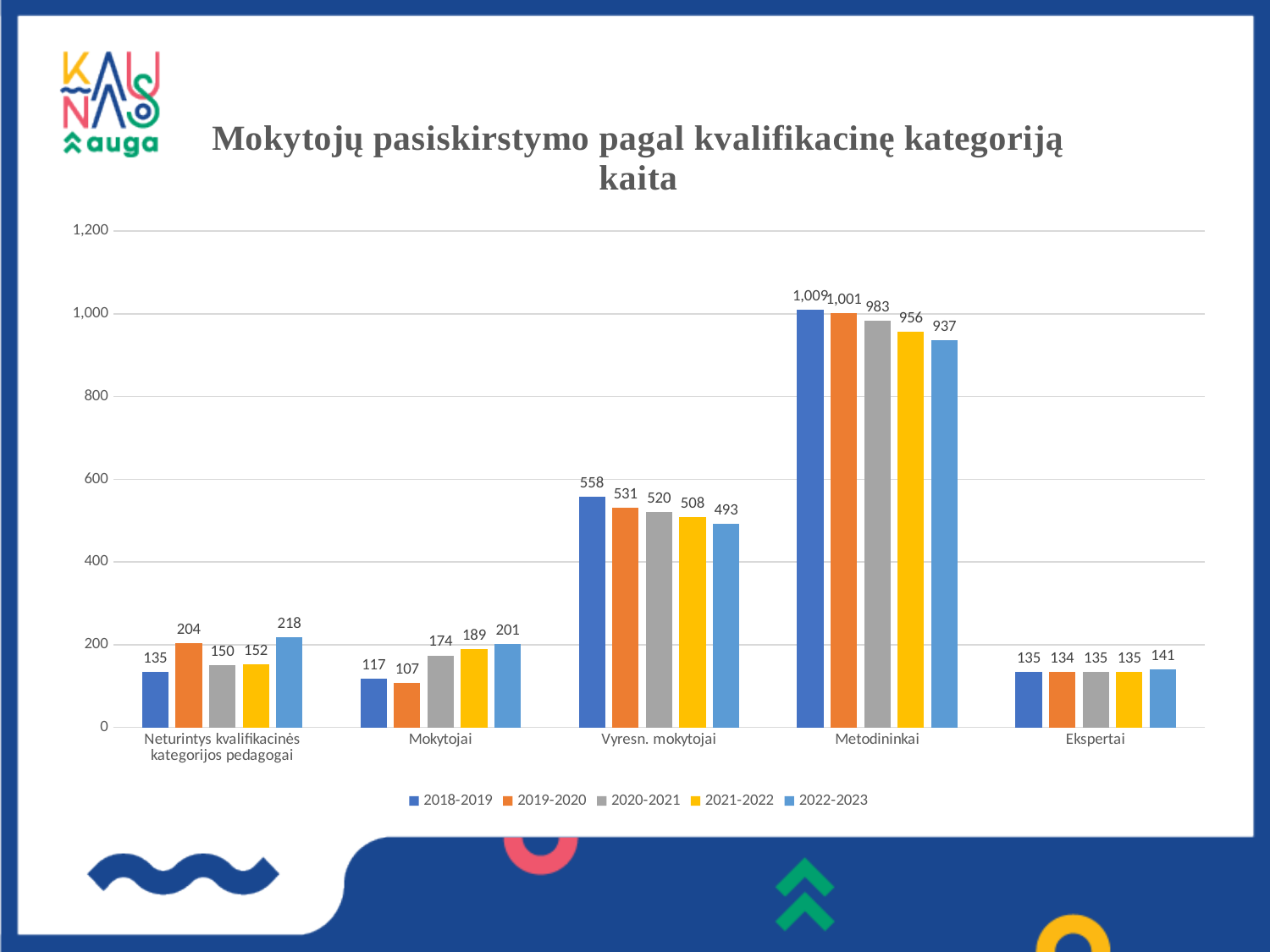
What is the value for Metodininkai in 2022-2023? 937 Which is larger for Neturintys kvalifikacinės kategorijos pedagogai: the 2019-2020 value or the 2022-2023 value? 2022-2023 What is the title of the chart? Mokytojų pasiskirstymo pagal kvalifikacinę kategoriją kaita Do the values for Metodininkai rise or fall from 2018-2019 to 2022-2023? fall What kind of chart is shown on the slide? bar chart How many series does the legend list? 5 How many categories are shown on the x axis? 5 Which category has the highest value in 2018-2019? Metodininkai What is the difference between the 2018-2019 and 2022-2023 values for Vyresn. mokytojai? 65 What is the value for Mokytojai in 2019-2020? 107 What is the value for Ekspertai in 2022-2023? 141 Which category has the lowest value in 2019-2020? Mokytojai